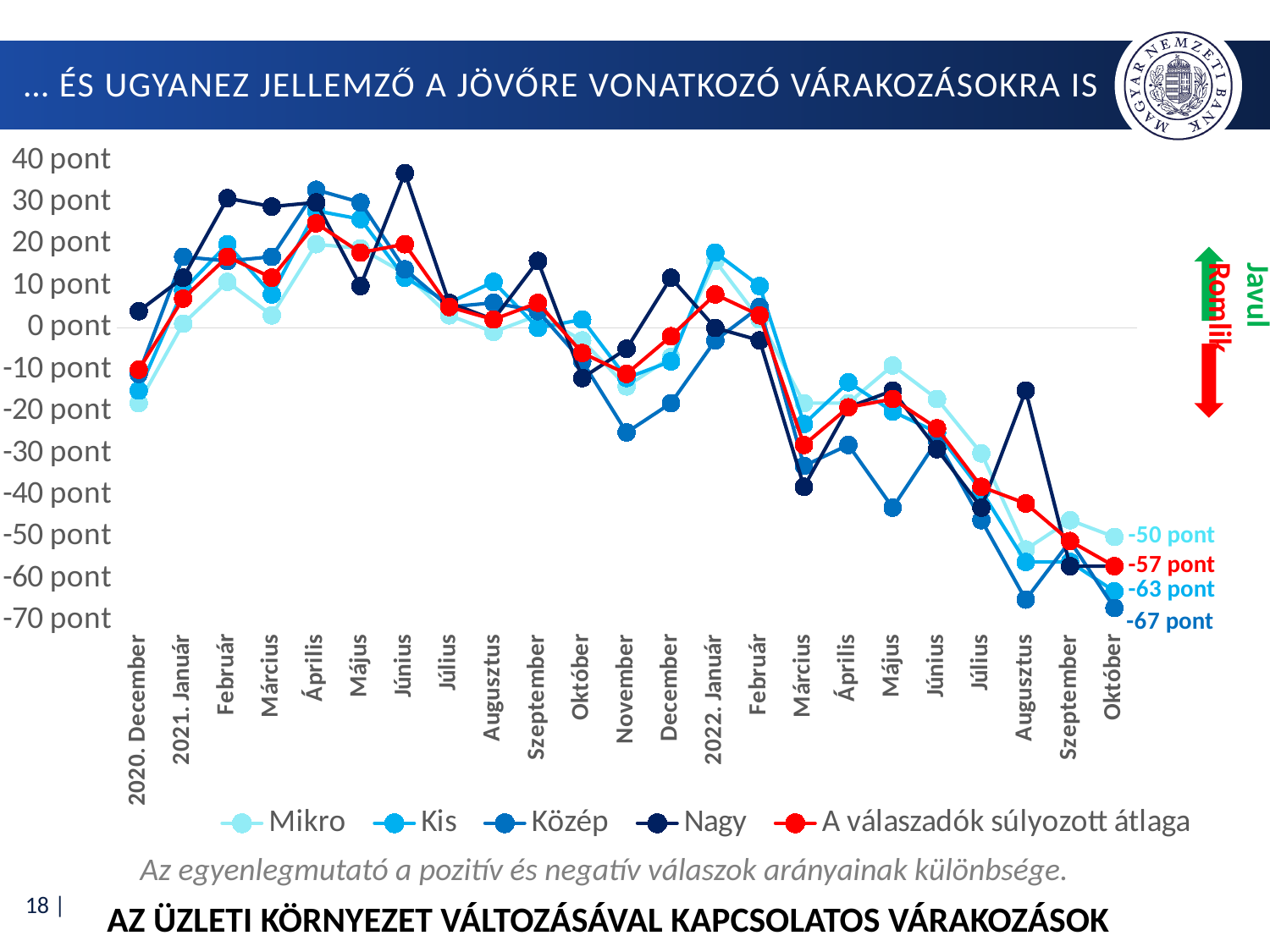
What is the value for Közép in 2022 Október? -67 pont Is the value for Nagy in 2021 Június greater or less than 30 pont? greater In 2022 Október, which is higher: Mikro or Kis? Mikro Is the value for Közép in 2021 November greater or less than -20 pont? less What is the difference between the Mikro and Közép values in 2022 Október? 17 pont What kind of chart is shown on the slide? line chart What is the value for Kis in 2022 Október? -63 pont Does the weighted average ('A válaszadók súlyozott átlaga') rise or fall from 2022 Január to 2022 Október? fall How many months are shown on the x axis? 23 What is the value for Mikro in 2022 Október? -50 pont How many series does the legend list? 5 What is the value for 'A válaszadók súlyozott átlaga' in 2022 Október? -57 pont